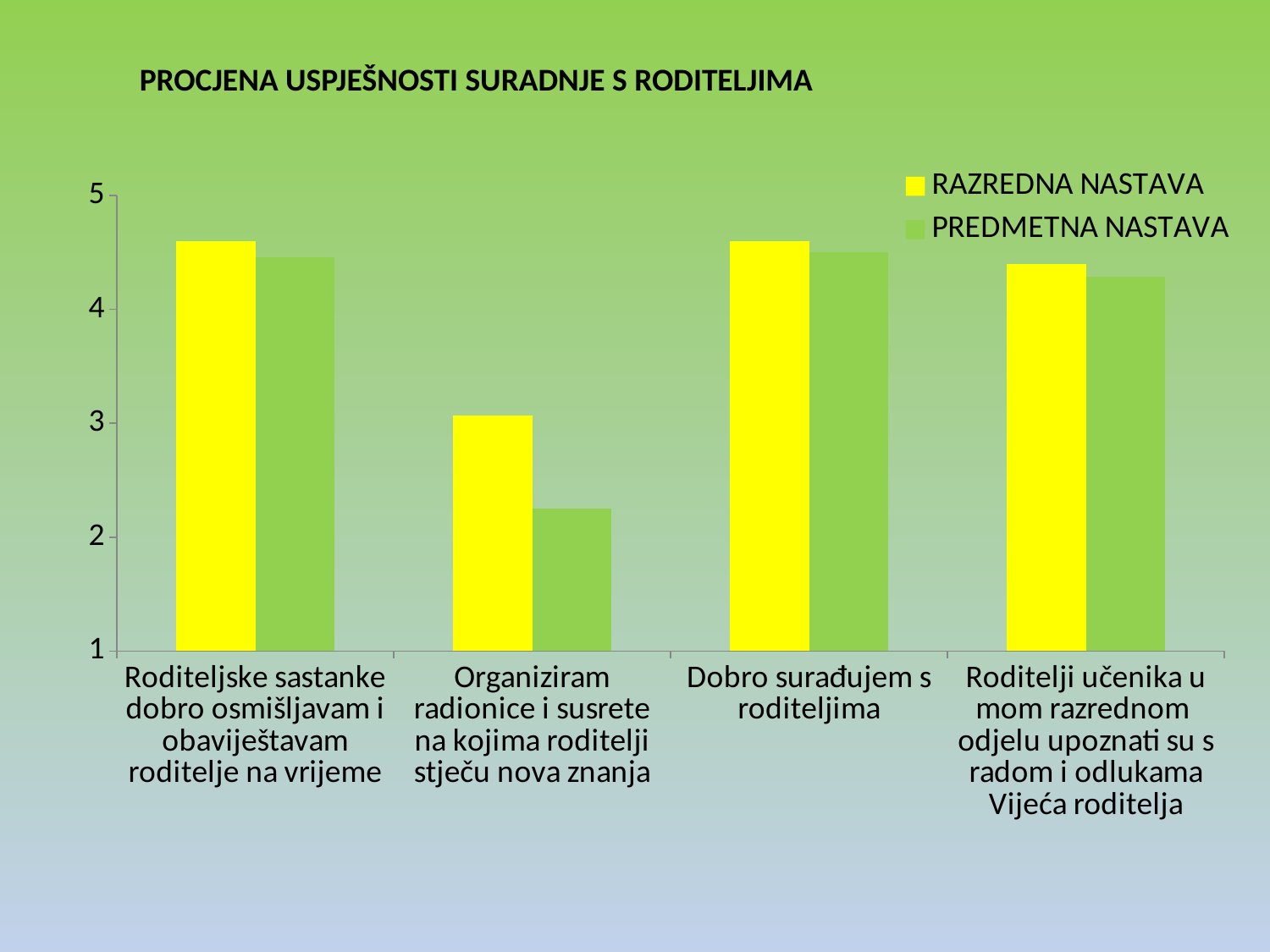
What kind of chart is shown on the slide? bar chart Which category has the lowest value for RAZREDNA NASTAVA? Organiziram radionice i susrete na kojima roditelji stječu nova znanja How many categories are shown on the x axis? 4 For 'Organiziram radionice i susrete na kojima roditelji stječu nova znanja', which series has the larger value, RAZREDNA NASTAVA or PREDMETNA NASTAVA? RAZREDNA NASTAVA How many series does the legend list? 2 Is the PREDMETNA NASTAVA value for 'Organiziram radionice i susrete na kojima roditelji stječu nova znanja' greater or less than 2? greater Which category has the lowest value for PREDMETNA NASTAVA? Organiziram radionice i susrete na kojima roditelji stječu nova znanja Is the PREDMETNA NASTAVA value for 'Roditelji učenika u mom razrednom odjelu upoznati su s radom i odlukama Vijeća roditelja' greater or less than 4? greater What is the title of the chart? PROCJENA USPJEŠNOSTI SURADNJE S RODITELJIMA Is the RAZREDNA NASTAVA value for 'Dobro surađujem s roditeljima' greater or less than 4? greater Which series is shown in yellow? RAZREDNA NASTAVA